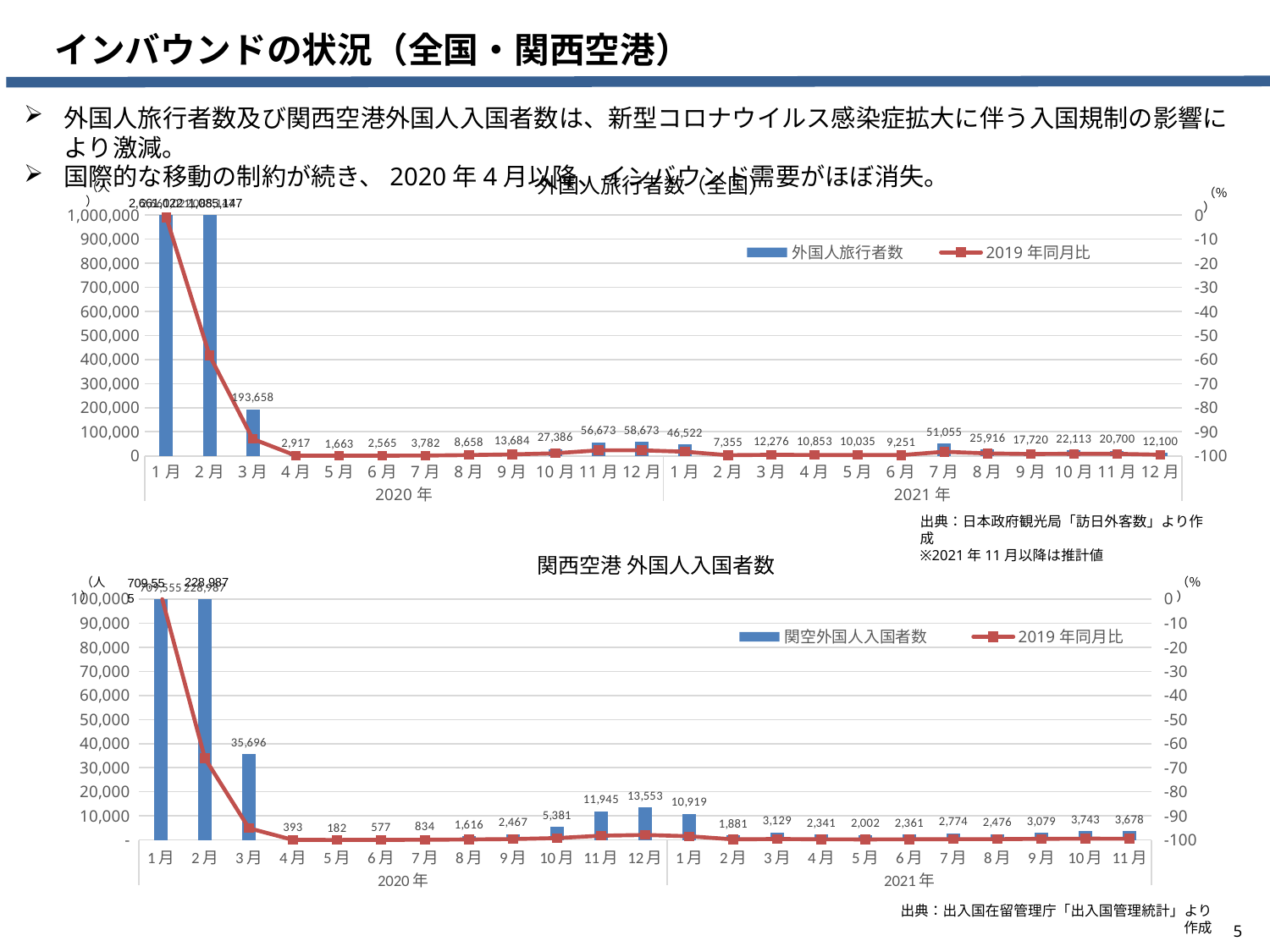
In the top chart (外国人旅行者数（全国）), which is larger, the value for 1月 2021 or 7月 2021? 7月 2021 In the top chart (外国人旅行者数（全国）), how many series does the legend list? 2 In the top chart (外国人旅行者数（全国）), what is the difference between the values for 12月 2020 and 11月 2020? 2,000 In the bottom chart (関西空港 外国人入国者数), what is the value for 12月 2020? 13,553 In the bottom chart (関西空港 外国人入国者数), which month has the lowest value? 5月 2020 (182) In the top chart (外国人旅行者数（全国）), what is the value for 3月 2020? 193,658 In the top chart (外国人旅行者数（全国）), which month has the lowest number of foreign travelers? 5月 2020 (1,663) In the bottom chart (関西空港 外国人入国者数), what is the difference between the values for 10月 2021 and 11月 2021? 65 In the bottom chart (関西空港 外国人入国者数), how many months are plotted on the x axis? 23 In the top chart (外国人旅行者数（全国）), what is the value for 7月 2021? 51,055 In the top chart (外国人旅行者数（全国）), do the values rise or fall from 5月 2020 to 12月 2020? rise What kind of chart is the bottom chart (関西空港 外国人入国者数)? Combined bar and line chart